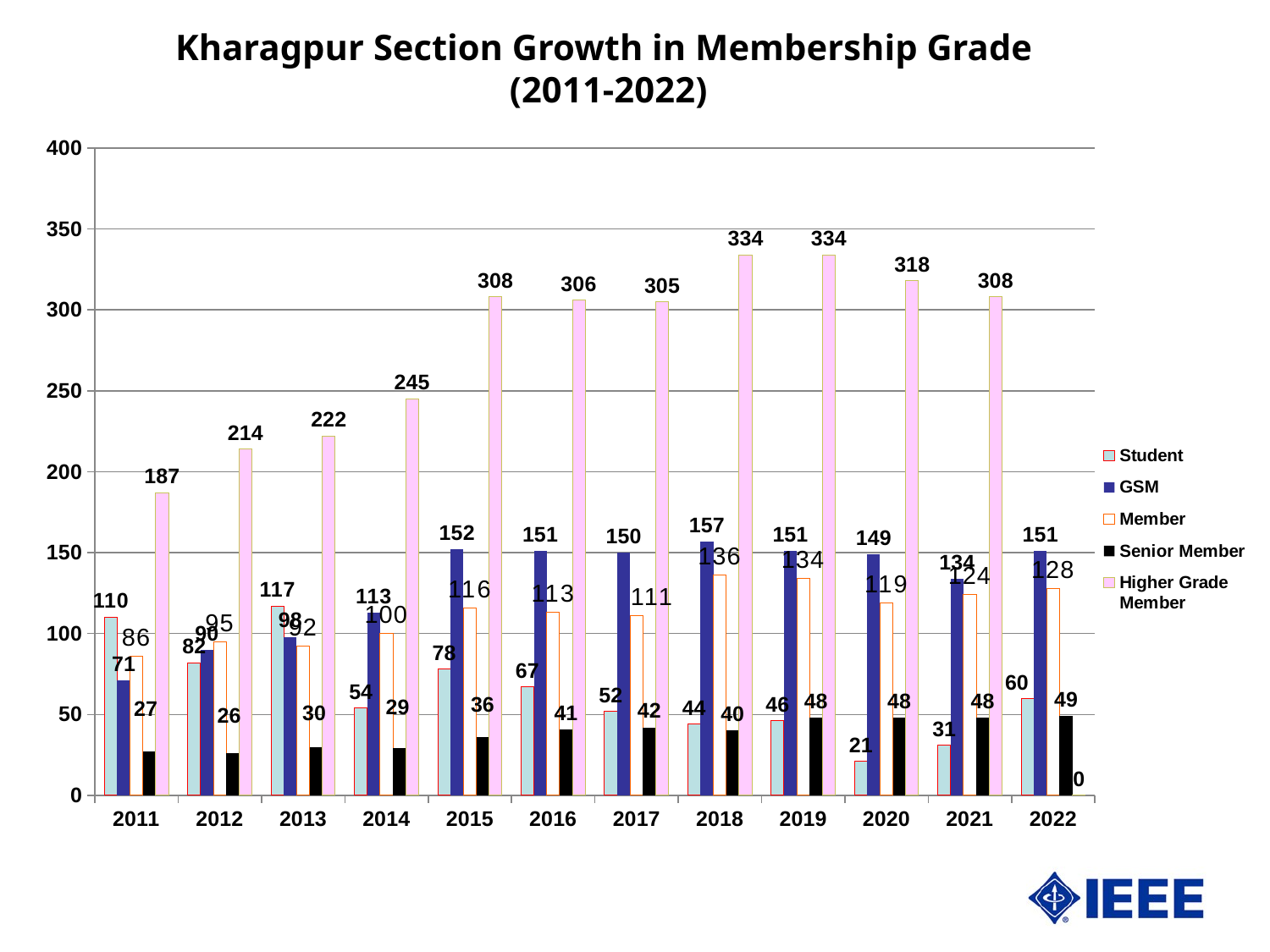
What kind of chart is shown on the slide? Bar chart How many series does the legend list? 5 How many years are shown on the x axis? 12 What is the Student value in 2011? 110 What is the value for Higher Grade Member in 2014? 245 In which year is the Student value lowest? 2020 What is the difference between the Higher Grade Member values in 2020 and 2021? 10 What is the Senior Member value in 2022? 49 In which year is the GSM value highest? 2018 Does the Higher Grade Member value rise or fall from 2011 to 2019? Rise In 2013, which is larger: the Student value or the Member value? Student Is the Higher Grade Member value for 2015 greater or less than 300? greater